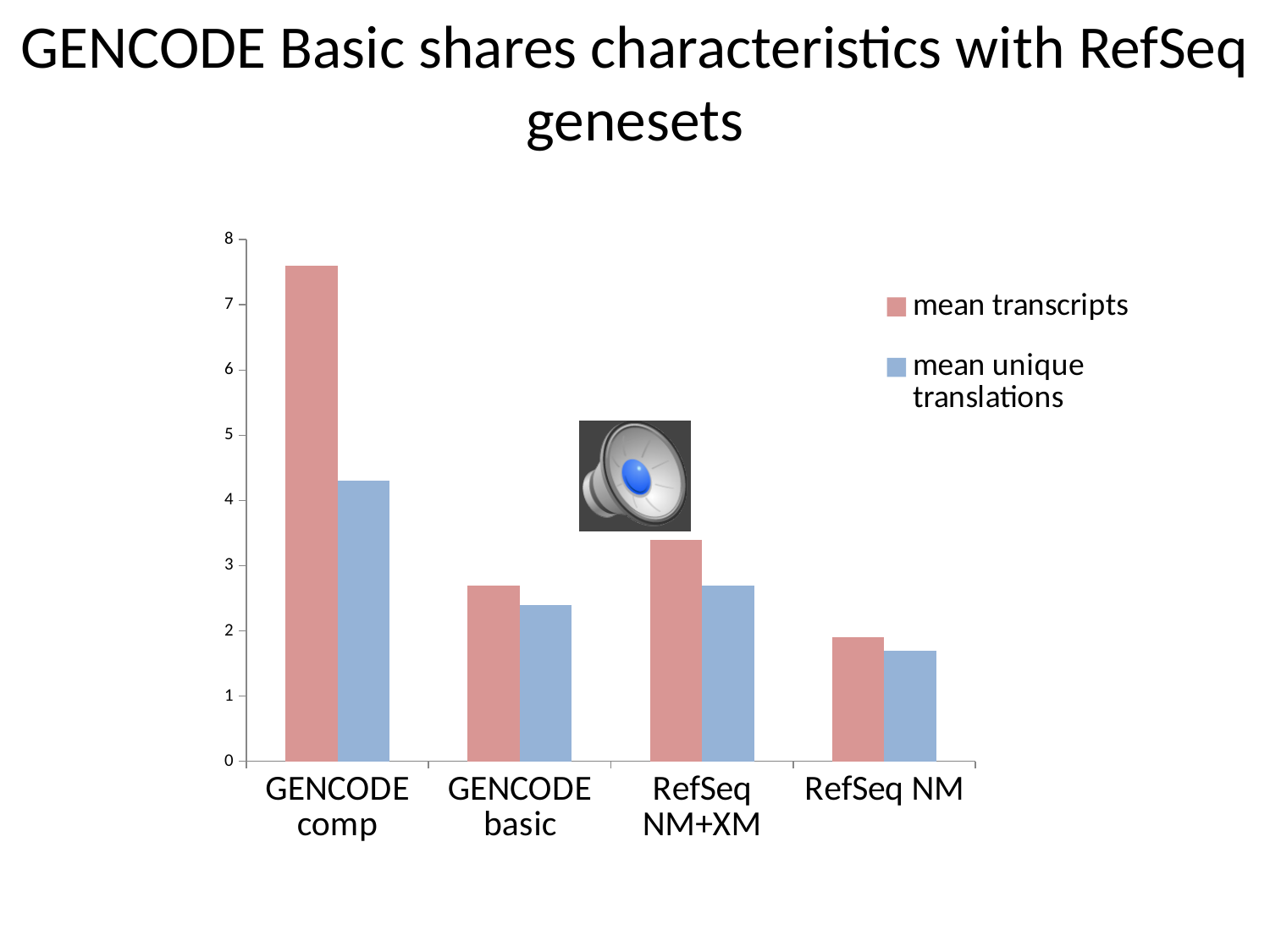
How many genesets (categories) are shown on the x axis? 4 Is the mean transcripts value for GENCODE comp greater or less than 7? greater How many series does the legend list? 2 Is the mean unique translations value for GENCODE comp greater or less than 4? greater Is the mean transcripts value for GENCODE basic greater or less than 3? less Which is larger: the mean transcripts value for GENCODE basic or for RefSeq NM+XM? RefSeq NM+XM Which colour represents the mean unique translations series? blue Which geneset has the highest mean transcripts value? GENCODE comp Which geneset has the lowest mean transcripts value? RefSeq NM What kind of chart is shown on the slide? bar chart Which geneset has the highest mean unique translations value? GENCODE comp